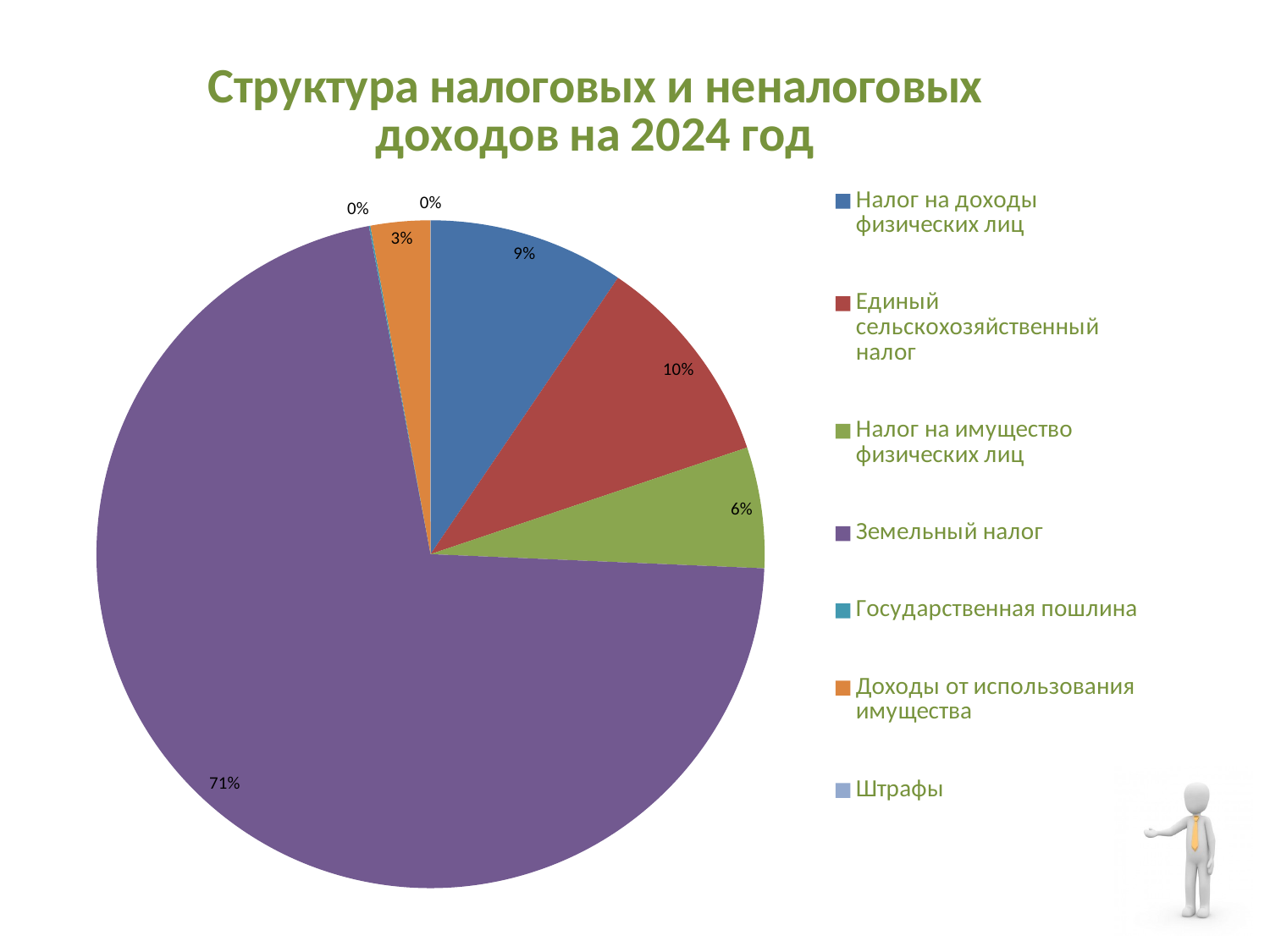
What is the difference between the shares of Земельный налог and Единый сельскохозяйственный налог? 61% What is the value shown for Единый сельскохозяйственный налог? 10% Which category has the largest slice of the pie? Земельный налог What is the value shown for Налог на имущество физических лиц? 6% What is the title of the chart? Структура налоговых и неналоговых доходов на 2024 год What kind of chart is shown on the slide? pie chart What is the value shown for Налог на доходы физических лиц? 9% Which is larger, Единый сельскохозяйственный налог or Налог на имущество физических лиц? Единый сельскохозяйственный налог How many categories does the legend list? 7 What share of the pie does Земельный налог have? 71% Which colour represents Земельный налог in the chart? purple What is the value shown for Доходы от использования имущества? 3%